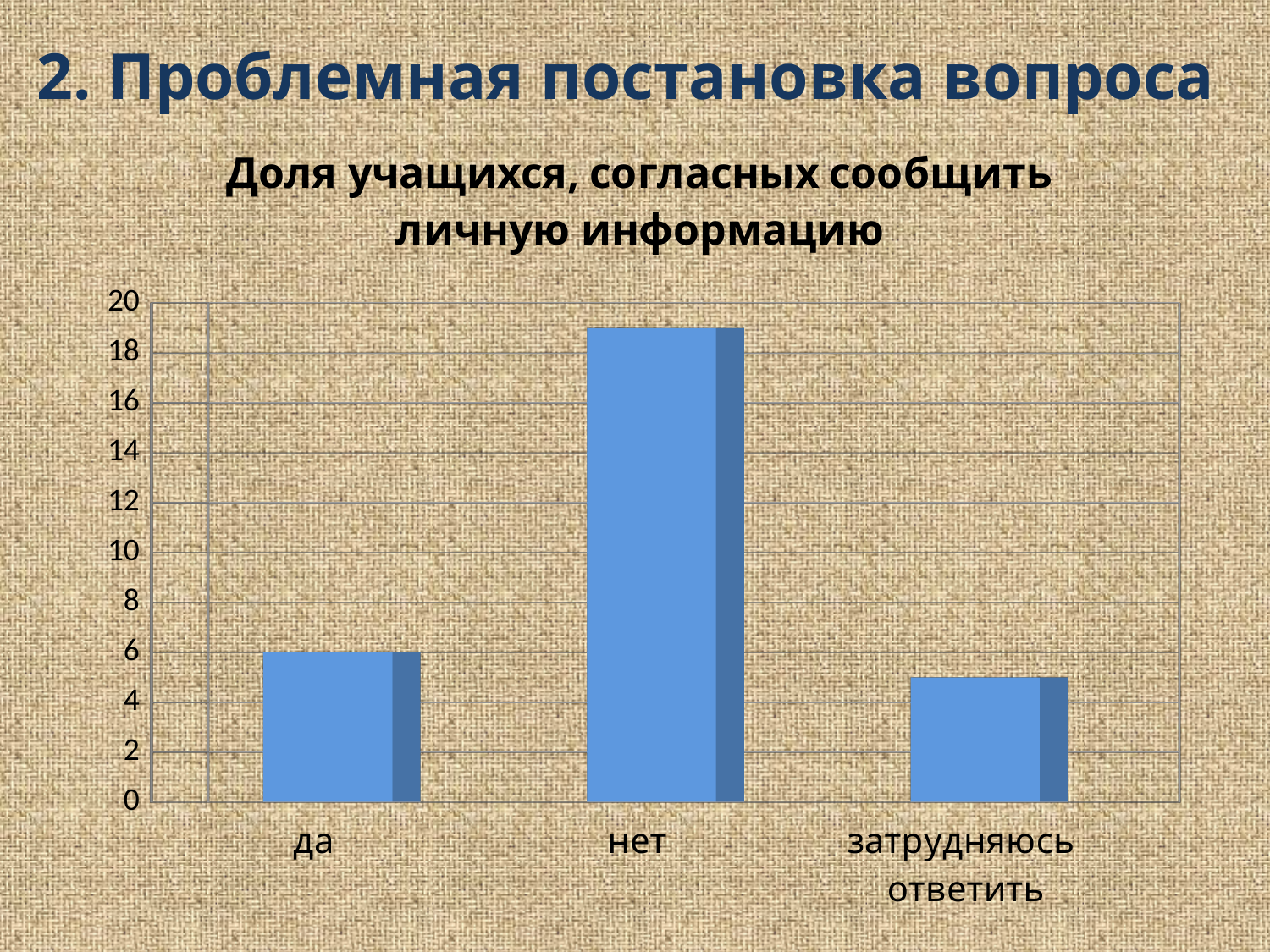
Which is larger, the value for "да" or the value for "нет"? нет Is the value for "затрудняюсь ответить" greater or less than 6? less What is the highest value shown on the vertical axis of the chart? 20 Is the value for "нет" greater or less than 18? greater Is the value for "затрудняюсь ответить" greater or less than 4? greater Which category has the highest bar? нет Which category has the lowest bar? затрудняюсь ответить What kind of chart is shown on the slide? bar chart How many categories are shown on the x axis of the chart? 3 What is the title of the chart? Доля учащихся, согласных сообщить личную информацию